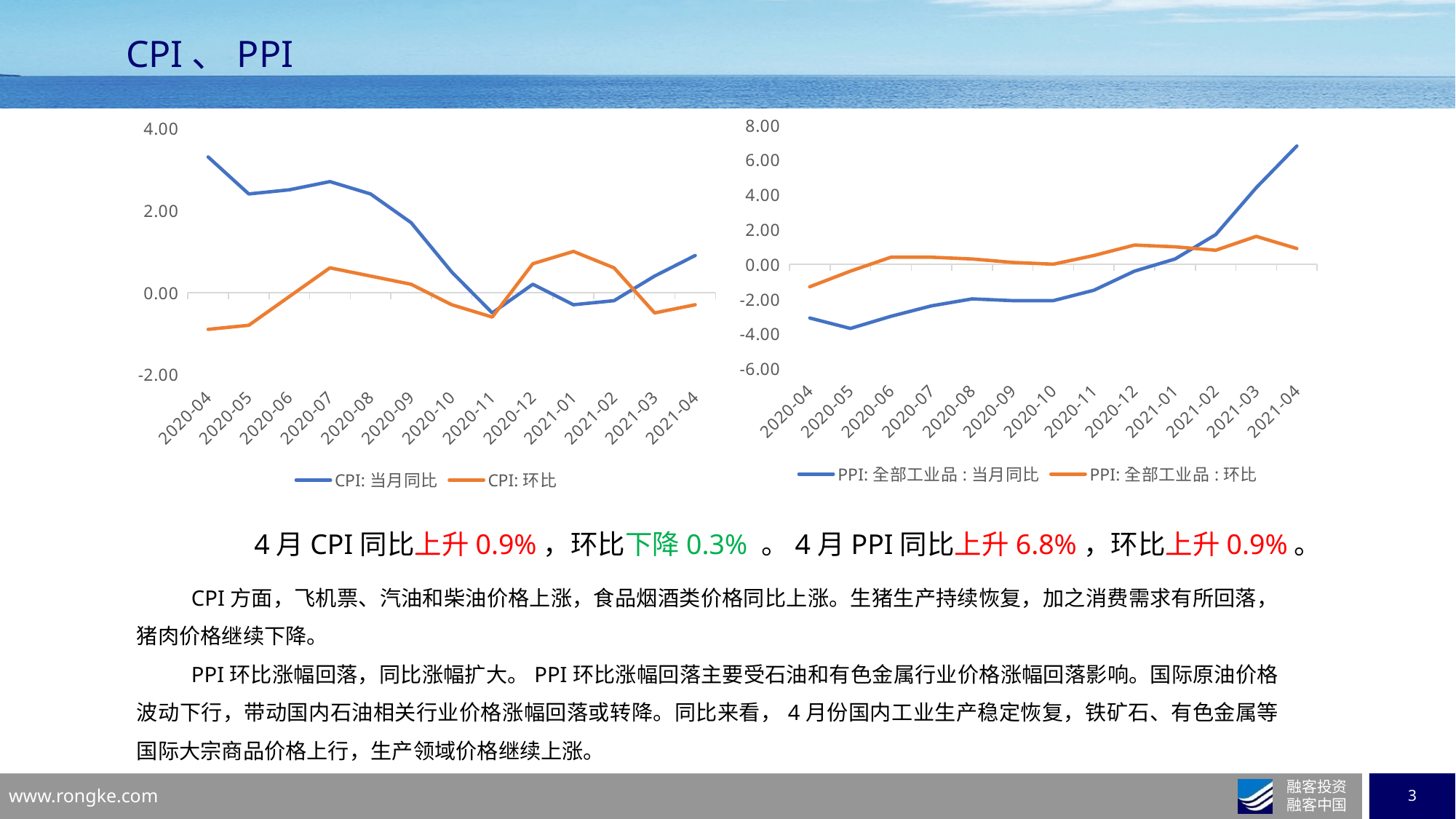
How many series does the legend of the right chart (PPI) list? 2 In the right chart (PPI), is the value for PPI: 全部工业品 : 当月同比 at 2021-04 greater or less than 6.00? greater In the left chart (CPI), which month has the highest value for CPI: 当月同比? 2020-04 In the right chart (PPI), which series has the larger value at 2021-04, PPI: 全部工业品 : 当月同比 or PPI: 全部工业品 : 环比? PPI: 全部工业品 : 当月同比 In the left chart (CPI), which month has the lowest value for CPI: 当月同比? 2020-11 What type of chart is the left chart (CPI)? line chart How many time points are shown on the x axis of the left chart (CPI)? 13 In the right chart (PPI), is the value for PPI: 全部工业品 : 当月同比 at 2020-05 greater or less than -2.00? less In the right chart (PPI), which month has the highest value for PPI: 全部工业品 : 环比? 2021-03 In the left chart (CPI), is the value for CPI: 当月同比 at 2020-04 greater or less than 2.00? greater In the right chart (PPI), does PPI: 全部工业品 : 当月同比 generally rise or fall from 2020-05 to 2021-04? rise In the right chart (PPI), which month has the lowest value for PPI: 全部工业品 : 当月同比? 2020-05